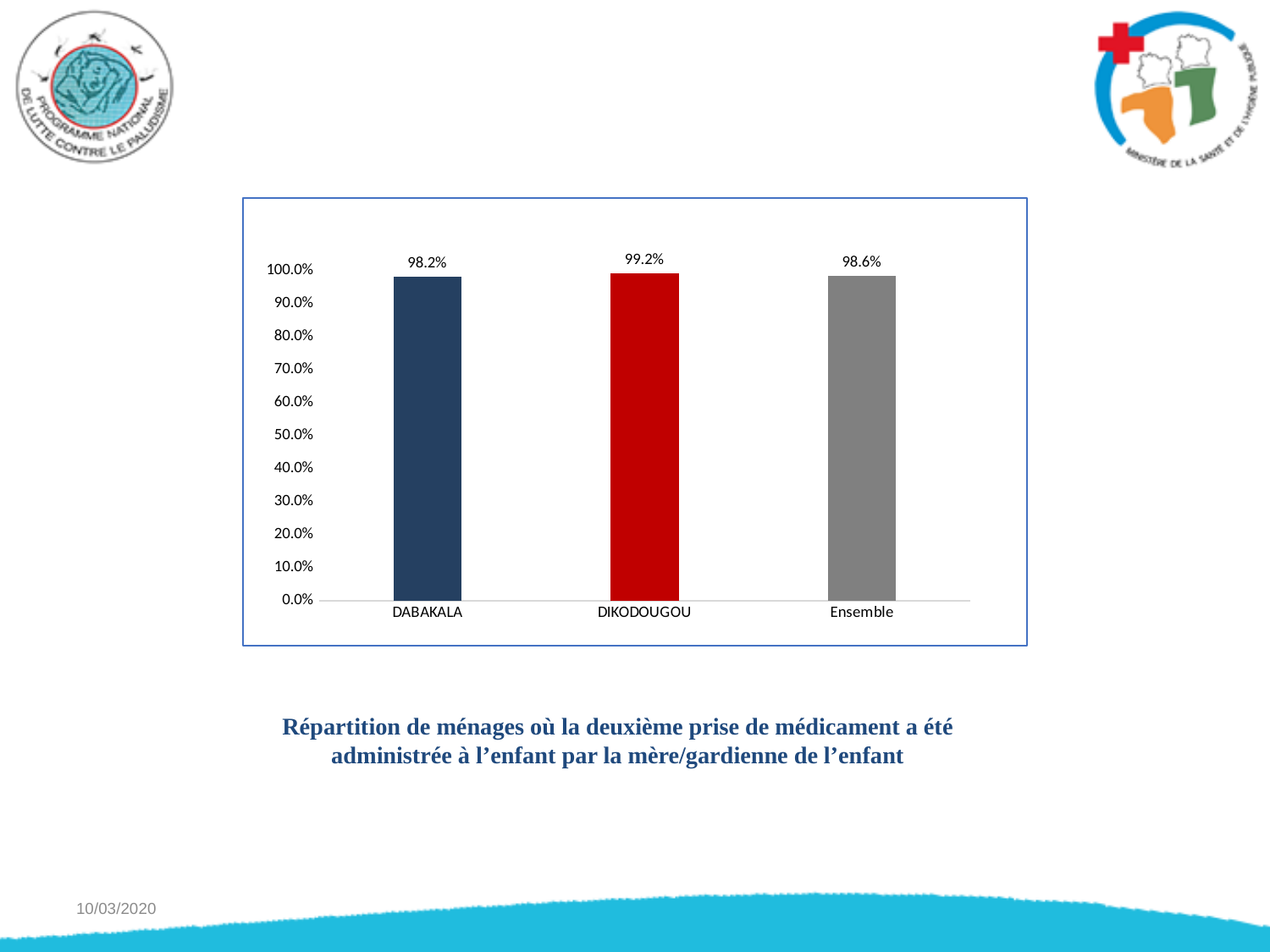
Is the value for DABAKALA greater or less than 90.0%? greater How many categories are shown on the x axis? 3 What kind of chart is shown on the slide? bar chart What colour is the bar for DIKODOUGOU? red What is the difference between the values for Ensemble and DABAKALA? 0.4% What is the value for DABAKALA? 98.2% Which category has the lowest value? DABAKALA Which category has the highest value? DIKODOUGOU What is the value for DIKODOUGOU? 99.2% What is the difference between the values for DIKODOUGOU and DABAKALA? 1.0% Which is larger, the value for DIKODOUGOU or the value for Ensemble? DIKODOUGOU What is the value for Ensemble? 98.6%